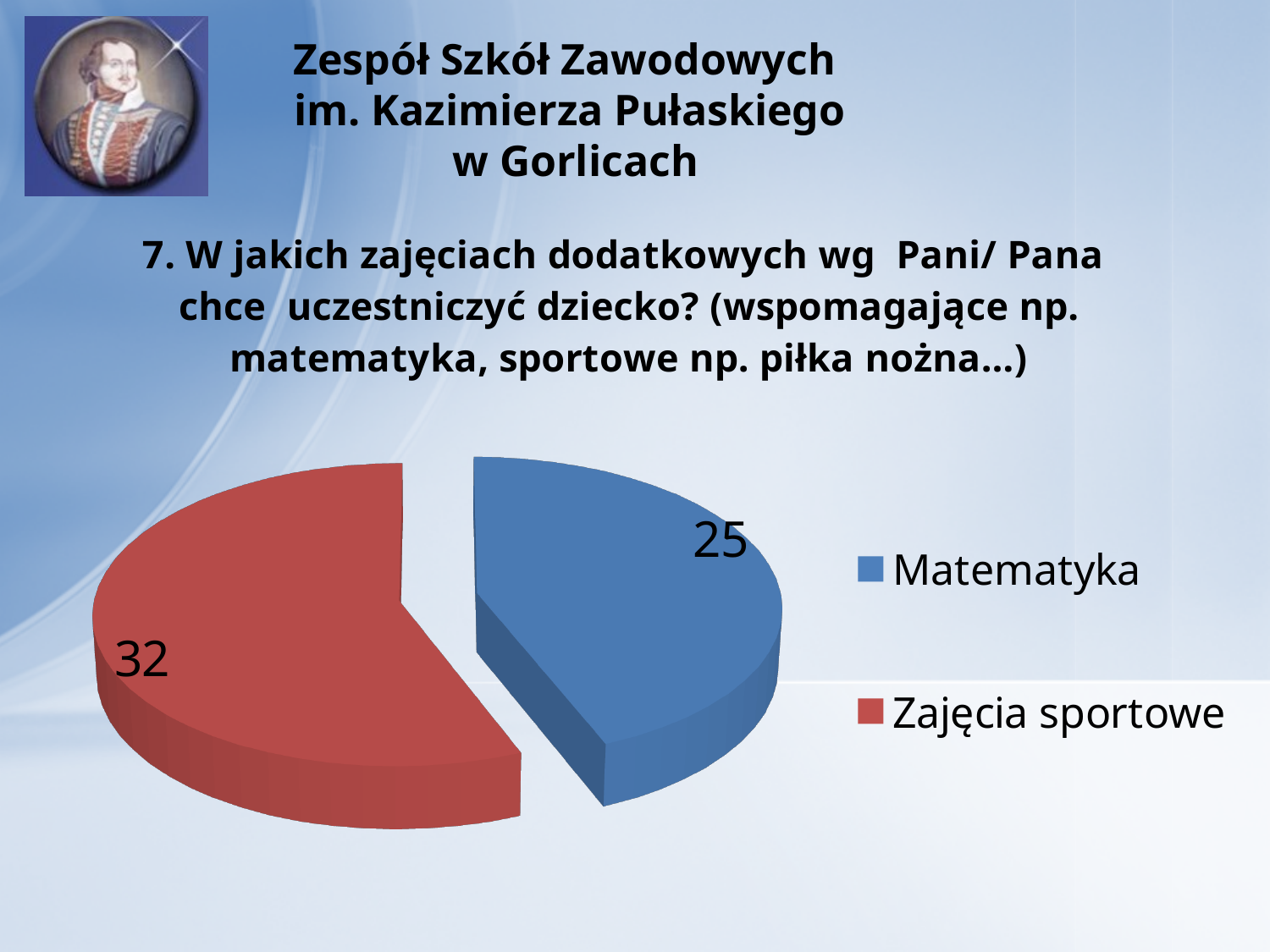
Which category has the smallest slice of the pie? Matematyka What value is shown for Zajęcia sportowe? 32 What is the difference between the values for Zajęcia sportowe and Matematyka? 7 Which category has the largest slice of the pie? Zajęcia sportowe What is the total of the two values shown in the pie chart? 57 What value is shown for Matematyka? 25 What kind of chart is shown on the slide? Pie chart What colour is the slice for Matematyka? Blue What colour is the slice for Zajęcia sportowe? Red How many categories does the pie chart show? 2 Which is larger, the value for Matematyka or the value for Zajęcia sportowe? Zajęcia sportowe